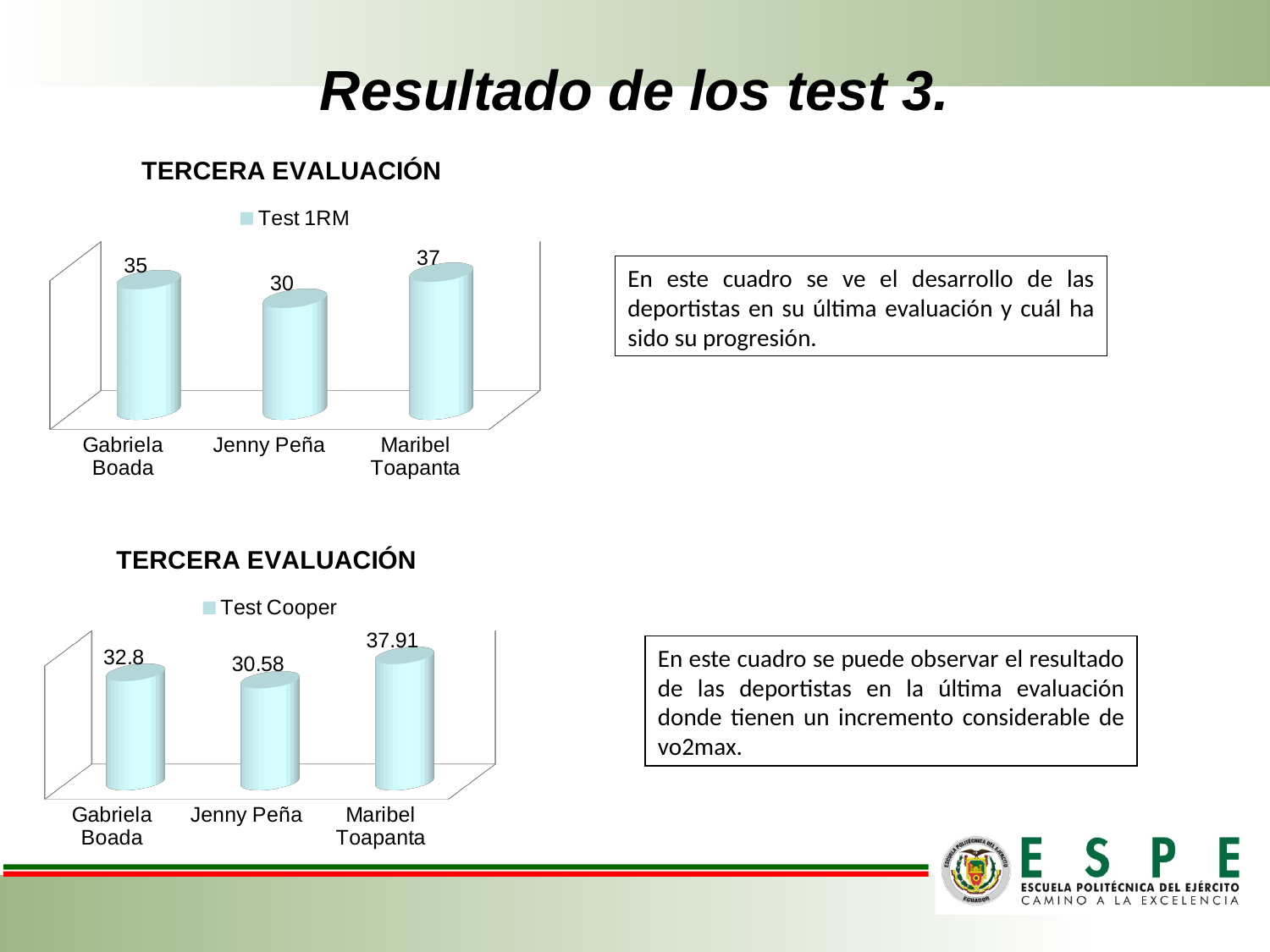
How many athletes are shown in the bottom chart (Test Cooper)? 3 In the top chart (Test 1RM), what is the value for Jenny Peña? 30 In the top chart (Test 1RM), what is the difference between Maribel Toapanta's and Jenny Peña's values? 7 In the bottom chart (Test Cooper), what is the value for Maribel Toapanta? 37.91 In the bottom chart (Test Cooper), which is larger, the value for Gabriela Boada or the value for Jenny Peña? Gabriela Boada In the bottom chart (Test Cooper), what is the value for Gabriela Boada? 32.8 In the top chart (Test 1RM), what is the value for Maribel Toapanta? 37 In the top chart (Test 1RM), which athlete has the highest value? Maribel Toapanta In the bottom chart (Test Cooper), which athlete has the lowest value? Jenny Peña What series name does the legend of the bottom chart show? Test Cooper What type of chart is the top chart (Test 1RM)? Bar chart In the top chart (Test 1RM), which athlete has the lowest value? Jenny Peña